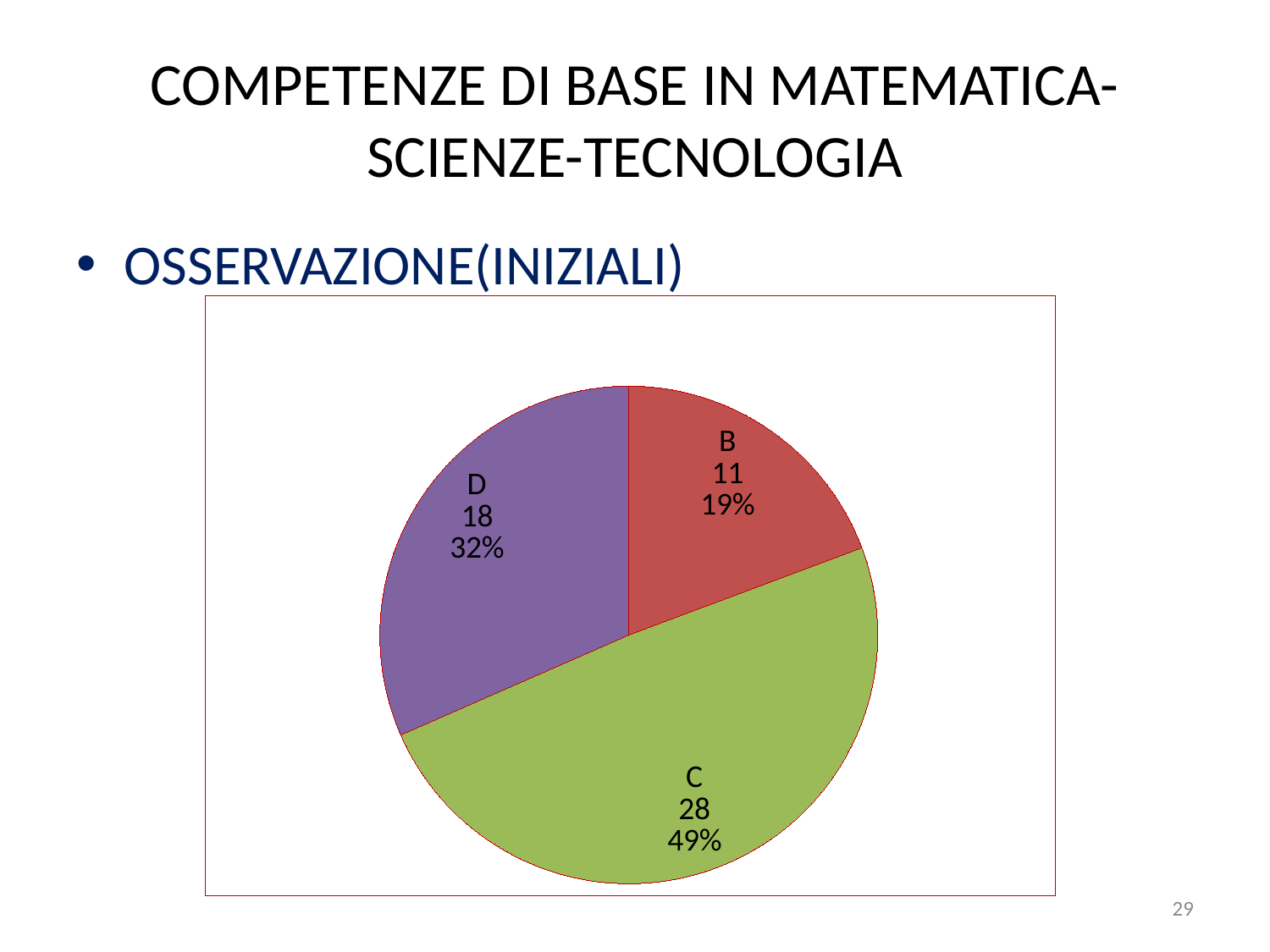
Which slice is the largest? C Which slice is the smallest? B Which is larger, the value for D or the value for B? D What is the value for slice B? 11 What percentage share of the pie does slice C have? 49% What is the difference between the values for C and D? 10 How many slices does the pie chart have? 3 What is the value for slice D? 18 What percentage share of the pie does slice D have? 32% What kind of chart is shown on the slide? pie chart What colour is slice C? green What is the value for slice C? 28